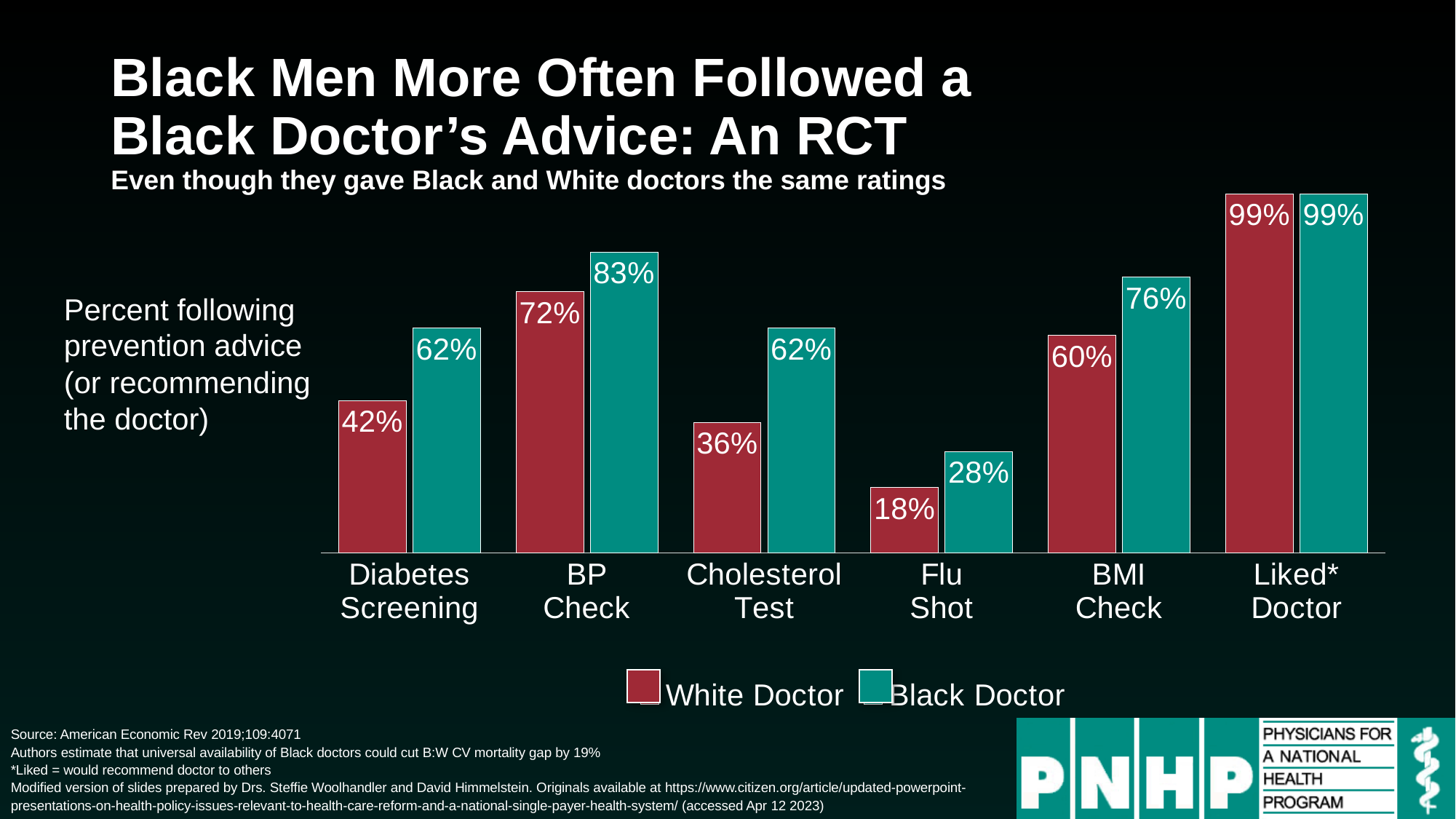
Which category has the lowest value for White Doctor? Flu Shot Which category has the highest value for Black Doctor? Liked* Doctor Which is larger for Cholesterol Test: the White Doctor value or the Black Doctor value? Black Doctor What is the difference between the Black Doctor and White Doctor values for BMI Check? 16% What kind of chart is shown on the slide? Bar chart Which colour represents Black Doctor in the legend? Teal What percent of Black men followed a Black doctor's advice for a BP Check? 83% What is the value for Black Doctor in the Diabetes Screening category? 62% How many series does the legend list? 2 How many categories are shown on the x axis? 6 What is the difference between the Black Doctor and White Doctor values for Diabetes Screening? 20% What is the value for White Doctor in the Flu Shot category? 18%